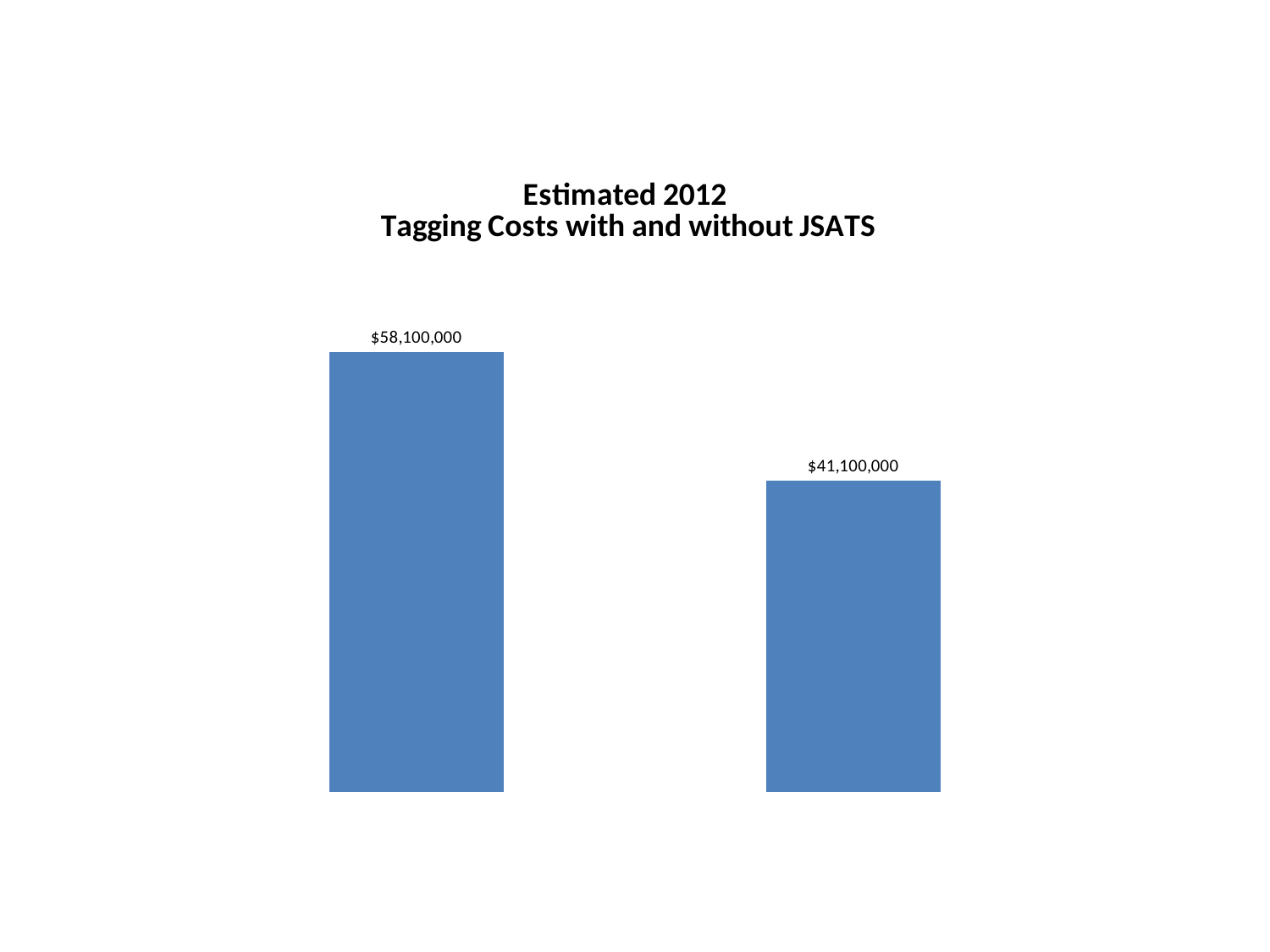
What is the title of the chart? Estimated 2012 Tagging Costs with and without JSATS What is the difference between the left bar's value and the right bar's value? $17,000,000 Which bar has the higher value, the left or the right? left How many bars are plotted on the chart? 2 Which bar has the lower value, the left or the right? right Is the value of the right bar larger or smaller than the value of the left bar? smaller What kind of chart is shown on the slide? bar chart What colour are the bars in the chart? blue What is the value shown on the left bar? $58,100,000 What is the value shown on the right bar? $41,100,000